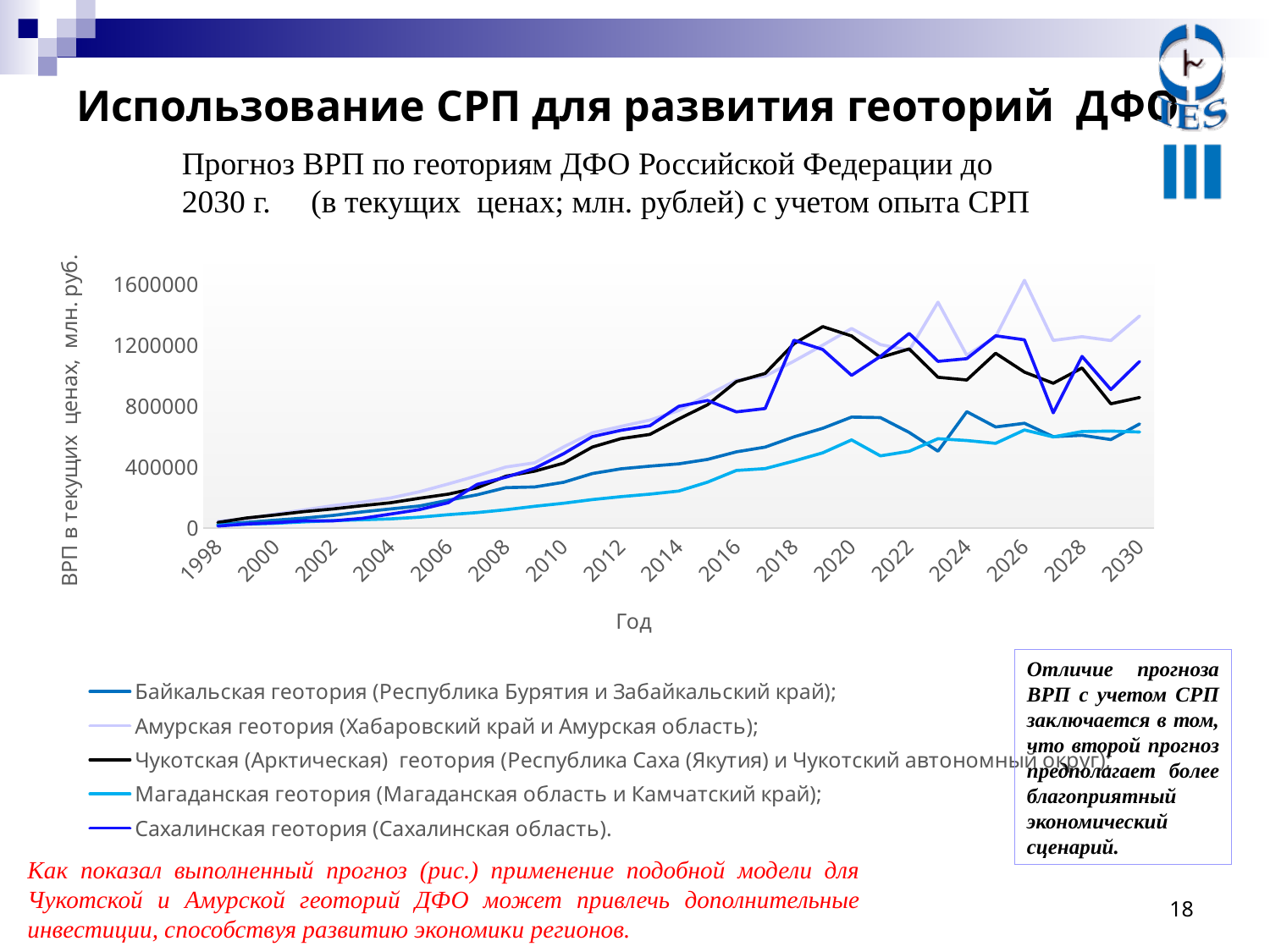
Which series has the lowest value in 2016? Магаданская геотория (Магаданская область и Камчатский край) What is the label of the x axis? Год What kind of chart is shown on the slide? line chart Is the value for Сахалинская геотория in 2030 greater or less than 800000? greater Is the value for Байкальская геотория in 2020 greater or less than 400000? greater What is the label of the y axis? ВРП в текущих ценах, млн. руб. In 2026, which is larger: the value for Амурская геотория or the value for Магаданская геотория? Амурская геотория Is the value for Магаданская геотория in 2030 greater or less than 800000? less How many series does the legend list? 5 Which series reaches the highest value on the chart? Амурская геотория (Хабаровский край и Амурская область) Do the values for Магаданская геотория generally rise or fall from 1998 to 2030? rise